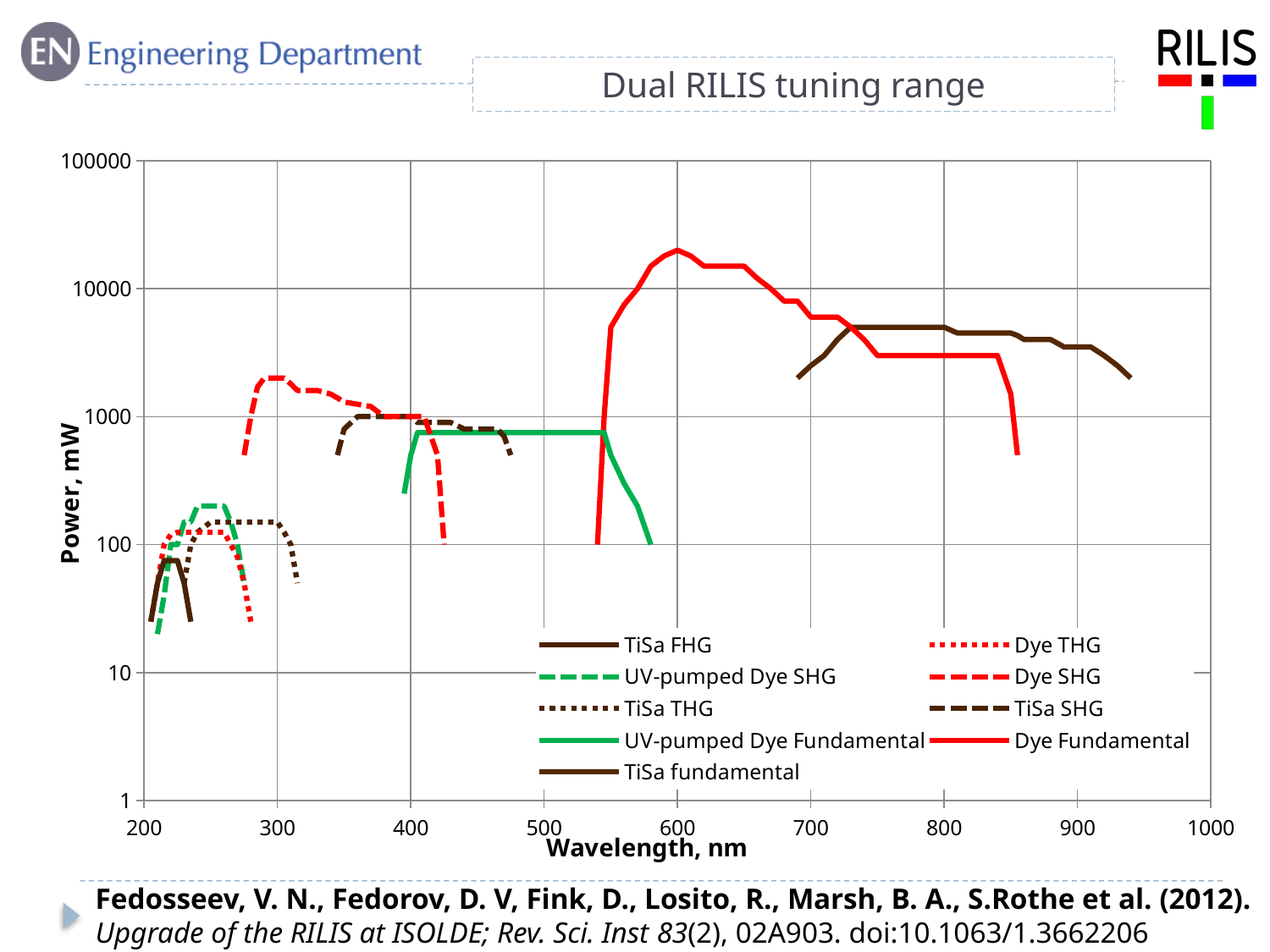
Is the power of the TiSa fundamental plateau greater or less than 1000 mW? greater How many series does the legend list? 9 What is the label of the vertical axis? Power, mW What is the title of the chart? Dual RILIS tuning range Is the peak power of the Dye SHG series greater or less than 1000 mW? greater Is the peak power of the Dye Fundamental series greater or less than 10000 mW? greater What kind of chart is shown on the slide? line chart Which series extends to the longest wavelength? TiSa fundamental Which series reaches a higher power, TiSa fundamental or UV-pumped Dye Fundamental? TiSa fundamental Which series reaches the highest power on the chart? Dye Fundamental